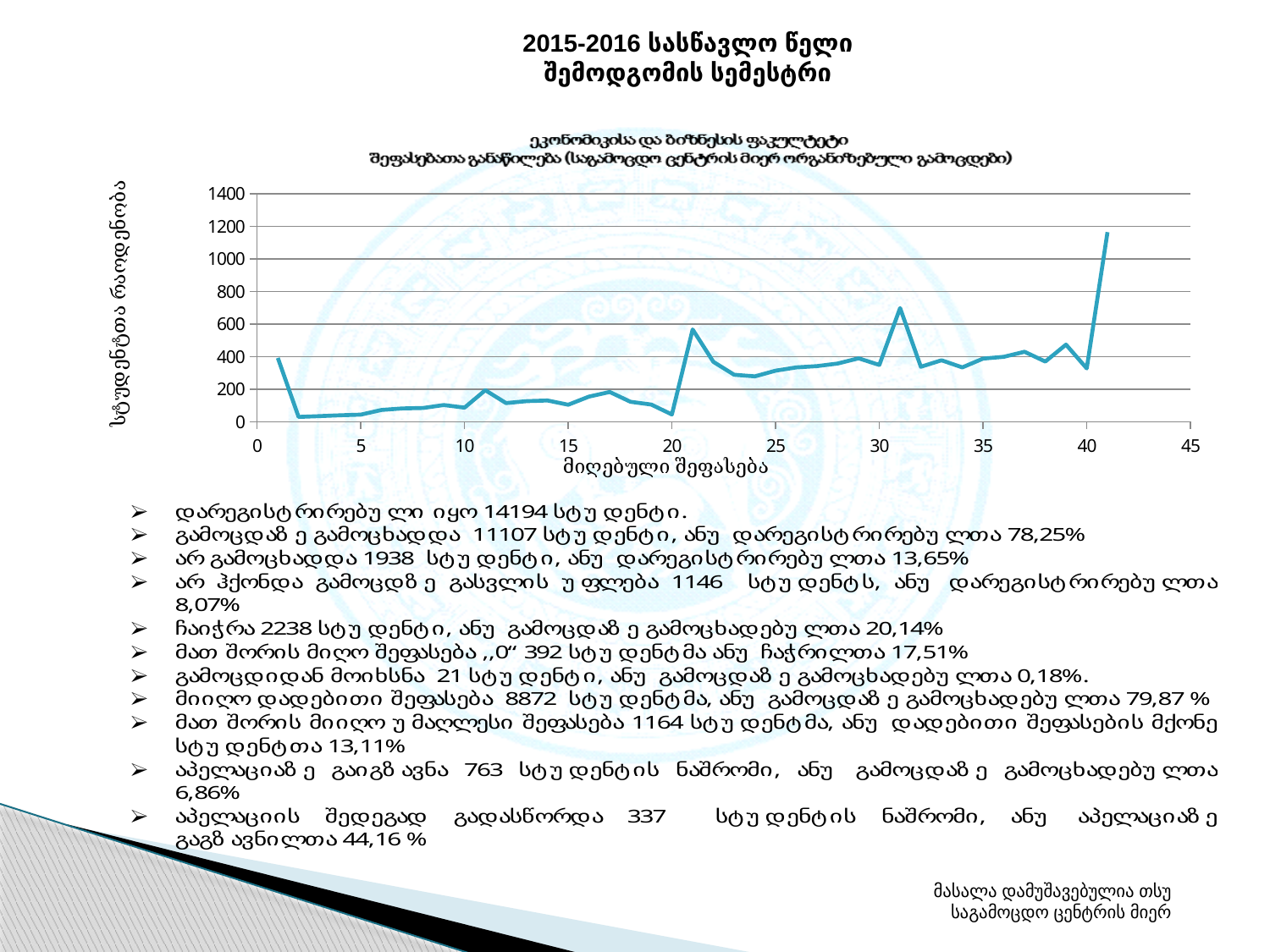
Is the value at x = 31 greater or less than 600? greater What kind of chart is shown on the slide? line chart Which is larger, the value at x = 31 or the value at x = 21? x = 31 Is the value at x = 25 greater or less than 400? less At which x-axis value (received grade) does the line reach its highest point? 41 What is the label of the vertical axis of the chart? სტუდენტთა რაოდენობა Is the value at x = 20 greater or less than 200? less What is the label of the horizontal axis of the chart? მიღებული შეფასება Does the line rise or fall between x = 21 and x = 24? fall